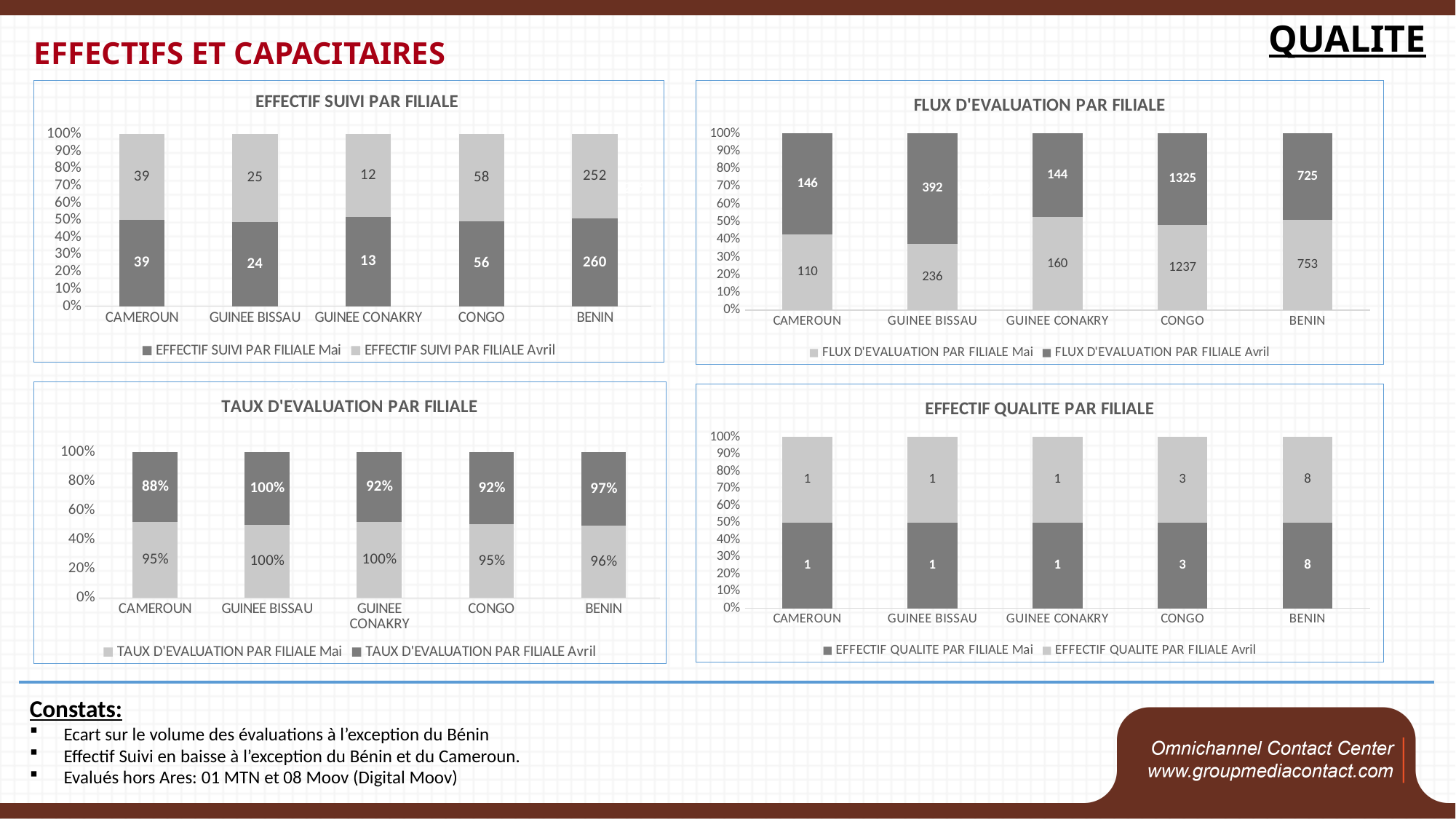
In the FLUX D'EVALUATION PAR FILIALE chart, what is the Avril value for CONGO? 1325 In the EFFECTIF QUALITE PAR FILIALE chart, what is the Mai value for BENIN? 8 In the TAUX D'EVALUATION PAR FILIALE chart, what is the Mai value for BENIN? 96% In the EFFECTIF SUIVI PAR FILIALE chart, what is the Mai value for BENIN? 260 In the FLUX D'EVALUATION PAR FILIALE chart, which filiale has the highest Mai value? CONGO In the EFFECTIF SUIVI PAR FILIALE chart, which filiale has the lowest Mai value? GUINEE CONAKRY In the FLUX D'EVALUATION PAR FILIALE chart, what is the difference between the Avril and Mai values for GUINEE BISSAU? 156 How many filiales are shown on the x axis of the EFFECTIF QUALITE PAR FILIALE chart? 5 In the FLUX D'EVALUATION PAR FILIALE chart, is the Mai value for BENIN larger or smaller than its Avril value? larger How many series does the legend of the TAUX D'EVALUATION PAR FILIALE chart list? 2 In the EFFECTIF SUIVI PAR FILIALE chart, what is the Avril value for CONGO? 58 In the TAUX D'EVALUATION PAR FILIALE chart, what is the Avril value for CAMEROUN? 88%